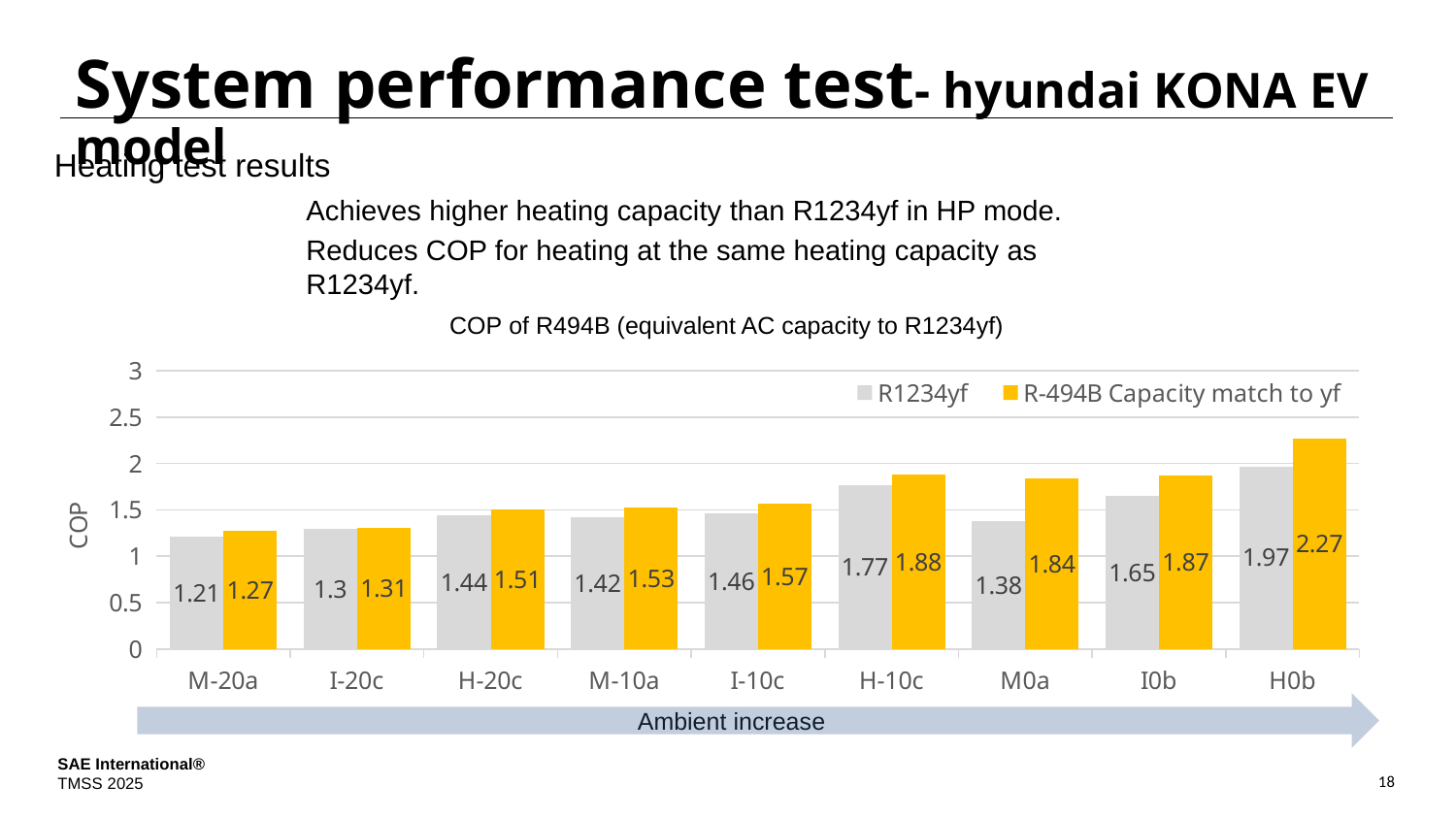
How many series does the legend list? 2 How many categories are shown on the x axis? 9 Is the COP of R-494B Capacity match to yf at H0b greater or less than 2? greater At I0b, which series has the higher COP, R1234yf or R-494B Capacity match to yf? R-494B Capacity match to yf What is the COP of R-494B Capacity match to yf at H0b? 2.27 What is the title of the chart? COP of R494B (equivalent AC capacity to R1234yf) What is the difference between the R-494B Capacity match to yf COP and the R1234yf COP at M0a? 0.46 Which category has the highest COP for R-494B Capacity match to yf? H0b What is the COP of R1234yf at M-20a? 1.21 Which category has the lowest COP for R1234yf? M-20a What kind of chart is shown on the slide? Bar chart What is the COP of R1234yf at H-10c? 1.77